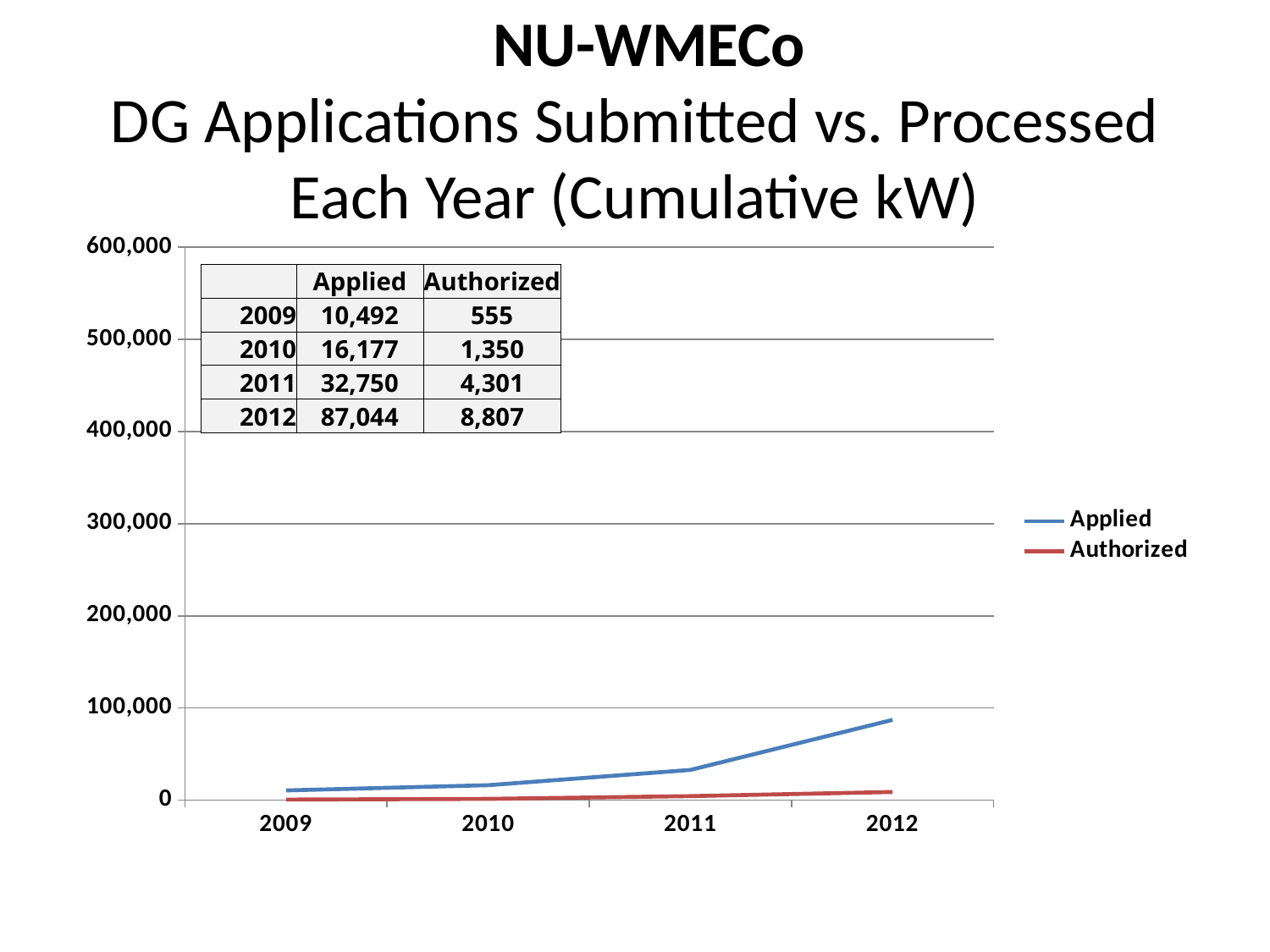
Is the Applied value for 2012 greater or less than 100,000? less How many years are plotted on the x axis? 4 What is the difference between the Applied and Authorized values in 2011? 28,449 What type of chart is shown on the slide? line chart Which year has the highest Applied value? 2012 Which is larger in 2012, the Applied value or the Authorized value? Applied Does the Applied series rise or fall from 2009 to 2012? rise Which year has the lowest Authorized value? 2009 What is the Applied value for 2012? 87,044 How many series does the legend list? 2 What is the Applied value for 2009? 10,492 What is the Authorized value for 2010? 1,350